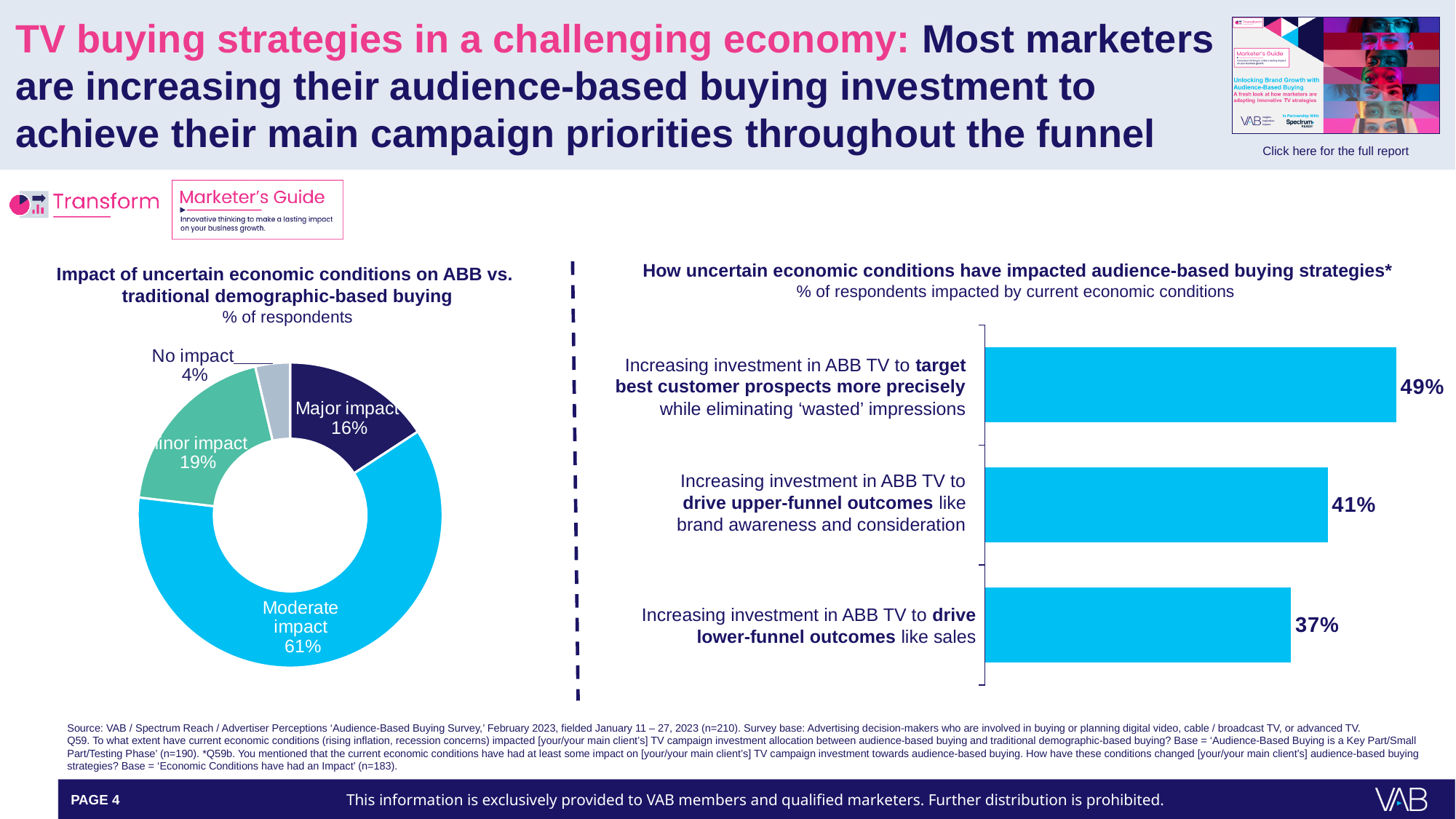
In the right chart, 'How uncertain economic conditions have impacted audience-based buying strategies', what is the difference in percentage points between the highest and lowest bars? 12 percentage points In the left chart, 'Impact of uncertain economic conditions on ABB vs. traditional demographic-based buying', what share of respondents reported no impact? 4% In the right chart, 'How uncertain economic conditions have impacted audience-based buying strategies', what percentage of respondents are increasing investment in ABB TV to drive upper-funnel outcomes? 41% In the left chart, 'Impact of uncertain economic conditions on ABB vs. traditional demographic-based buying', which category has the largest share? Moderate impact In the left chart, 'Impact of uncertain economic conditions on ABB vs. traditional demographic-based buying', which category has the smallest share? No impact In the left chart, 'Impact of uncertain economic conditions on ABB vs. traditional demographic-based buying', how many categories are shown? 4 What type of chart is the left chart, 'Impact of uncertain economic conditions on ABB vs. traditional demographic-based buying'? Pie (donut) chart In the right chart, 'How uncertain economic conditions have impacted audience-based buying strategies', which strategy has the highest percentage? Increasing investment in ABB TV to target best customer prospects more precisely while eliminating 'wasted' impressions What type of chart is the right chart, 'How uncertain economic conditions have impacted audience-based buying strategies'? Bar chart In the left chart, 'Impact of uncertain economic conditions on ABB vs. traditional demographic-based buying', which is larger: Minor impact or Major impact? Minor impact In the left chart, 'Impact of uncertain economic conditions on ABB vs. traditional demographic-based buying', what is the difference in percentage points between Minor impact and Major impact? 3 percentage points In the left chart, 'Impact of uncertain economic conditions on ABB vs. traditional demographic-based buying', what share of respondents reported a moderate impact? 61%